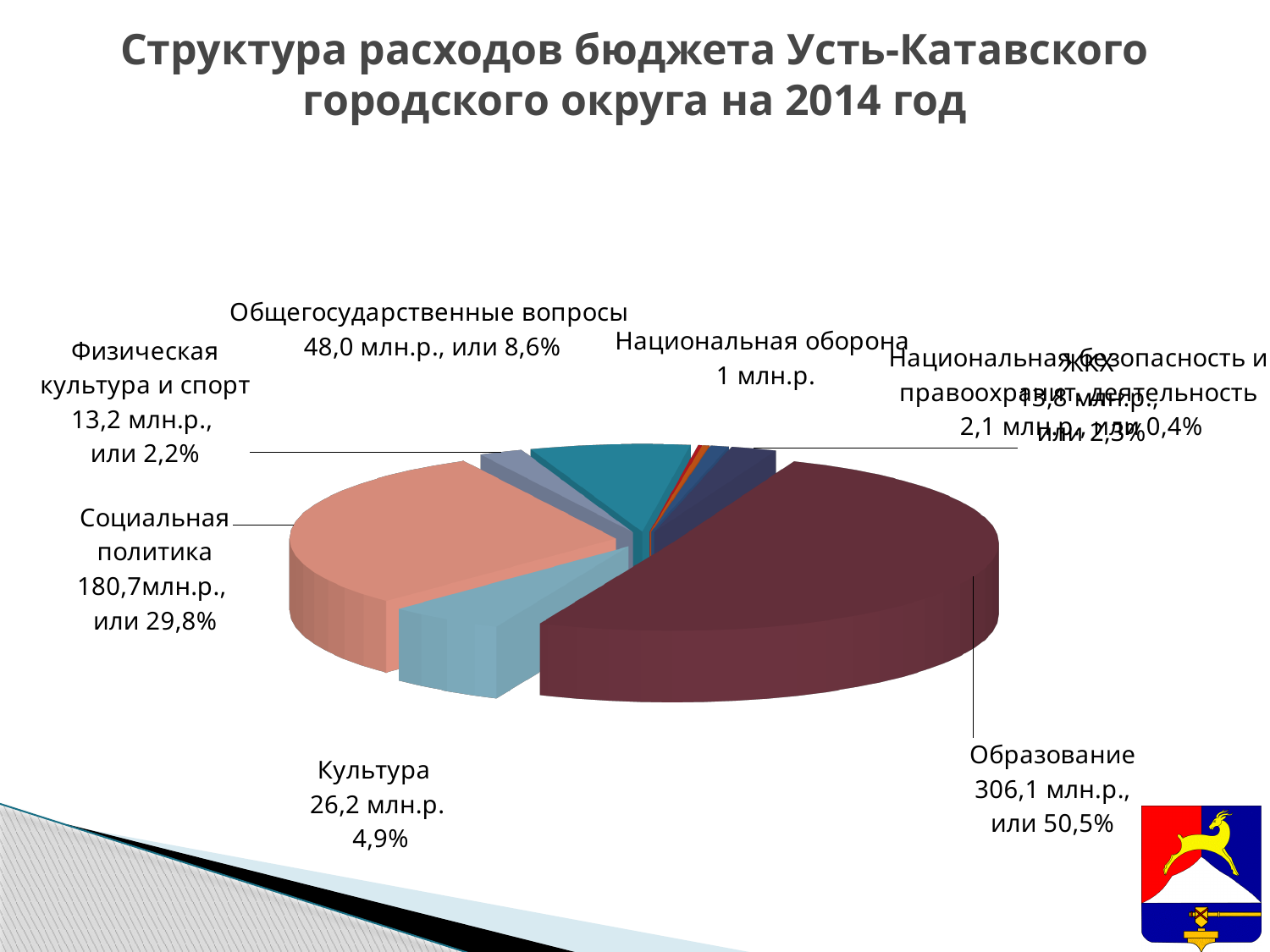
What kind of chart is shown on the slide? Pie chart Which is larger: the amount for Общегосударственные вопросы or for Культура? Общегосударственные вопросы What is the title of the chart on the slide? Структура расходов бюджета Усть-Катавского городского округа на 2014 год What amount in млн.р. is allocated to Социальная политика? 180,7млн.р. What is the difference in млн.р. between Образование and Социальная политика? 125,4 млн.р. What share of the budget goes to Общегосударственные вопросы? 8,6% What share of the budget goes to Физическая культура и спорт? 2,2% What share of the budget goes to Образование? 50,5% How many expenditure categories are shown in the pie chart? 9 Which expenditure category has the largest share of the budget? Образование What amount is allocated to Культура? 26,2 млн.р. Which expenditure category has the smallest amount? Национальная оборона